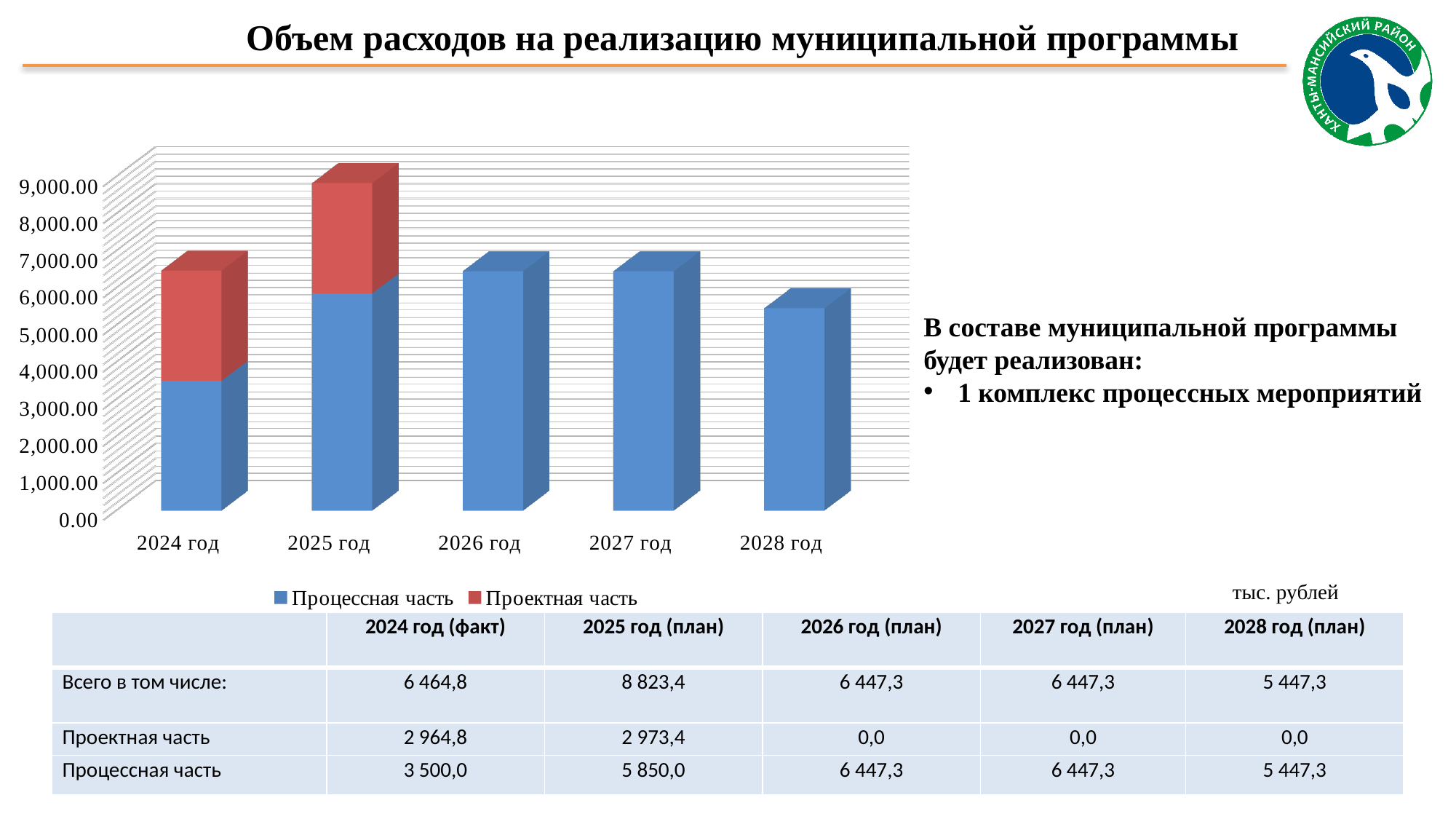
According to the table, what is the value of Проектная часть for 2024 год (факт)? 2 964,8 Which year has the lowest total bar in the chart? 2028 год What kind of chart is shown on the slide? Stacked bar chart Is the total value for 2024 год greater or less than 6,000.00? greater Which year has the highest total bar in the chart? 2025 год How many years (categories) are shown on the x axis of the chart? 5 Which bar is taller in the chart, 2026 год or 2028 год? 2026 год What colour represents Проектная часть in the chart? Red How many series does the chart legend list? 2 Is the value for 2028 год greater or less than 6,000.00? less According to the table, what is the value of Процессная часть for 2025 год (план)? 5 850,0 Using the table values, what is the difference between the total (Всего) for 2025 год and 2024 год? 2 358,6